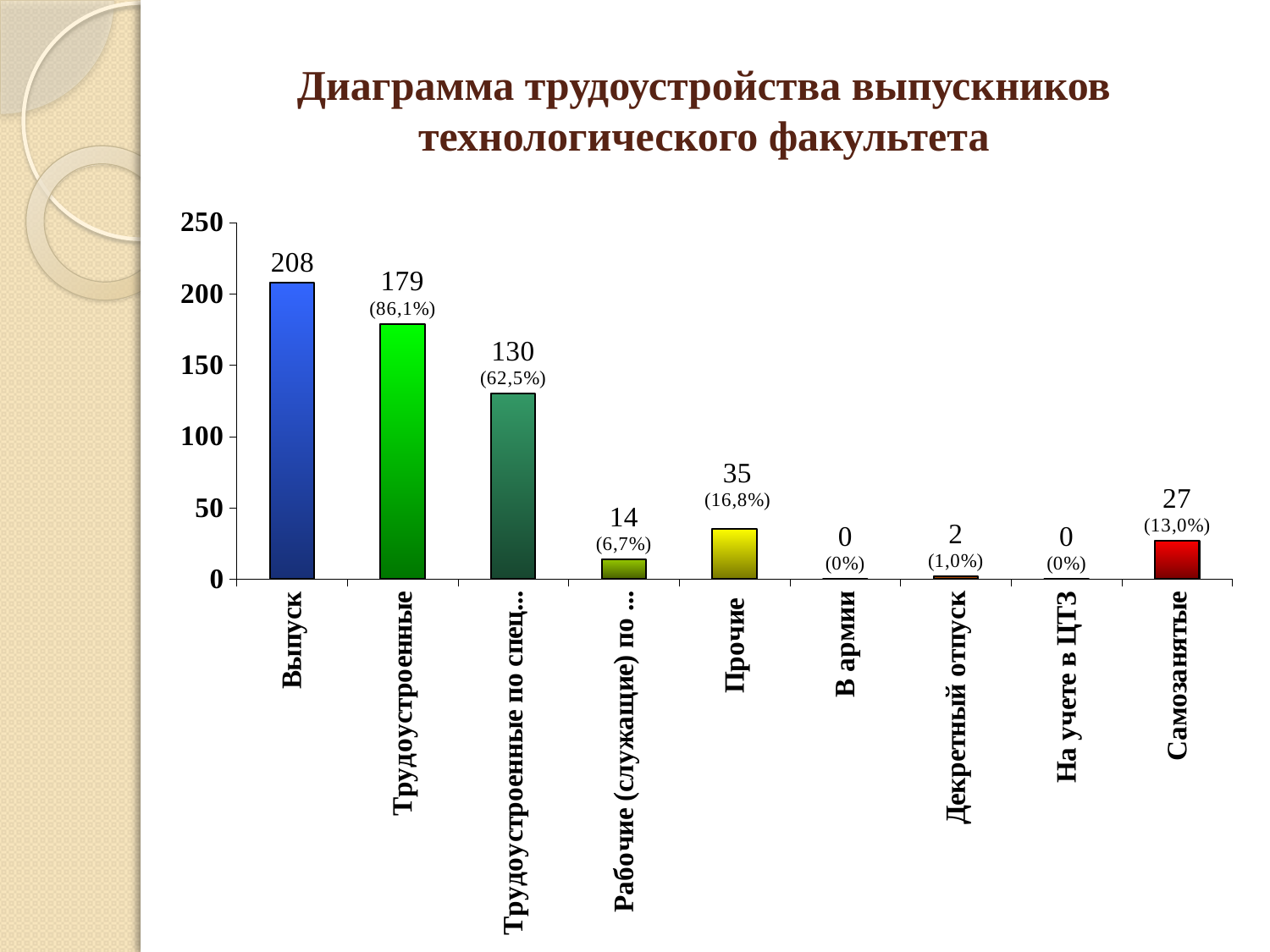
Which is larger, the value for Прочие or the value for Самозанятые? Прочие What percentage is shown for Самозанятые? 13,0% Is the value for Трудоустроенные по спец... greater or less than 100? greater What is the value for Декретный отпуск? 2 What is the value for Прочие? 35 Which category has the highest value? Выпуск How many categories are shown on the x axis? 9 What is the value for Трудоустроенные? 179 What is the difference between the values for Выпуск and Трудоустроенные? 29 What is the value for Выпуск? 208 What is the title of the chart? Диаграмма трудоустройства выпускников технологического факультета What kind of chart is shown on the slide? bar chart